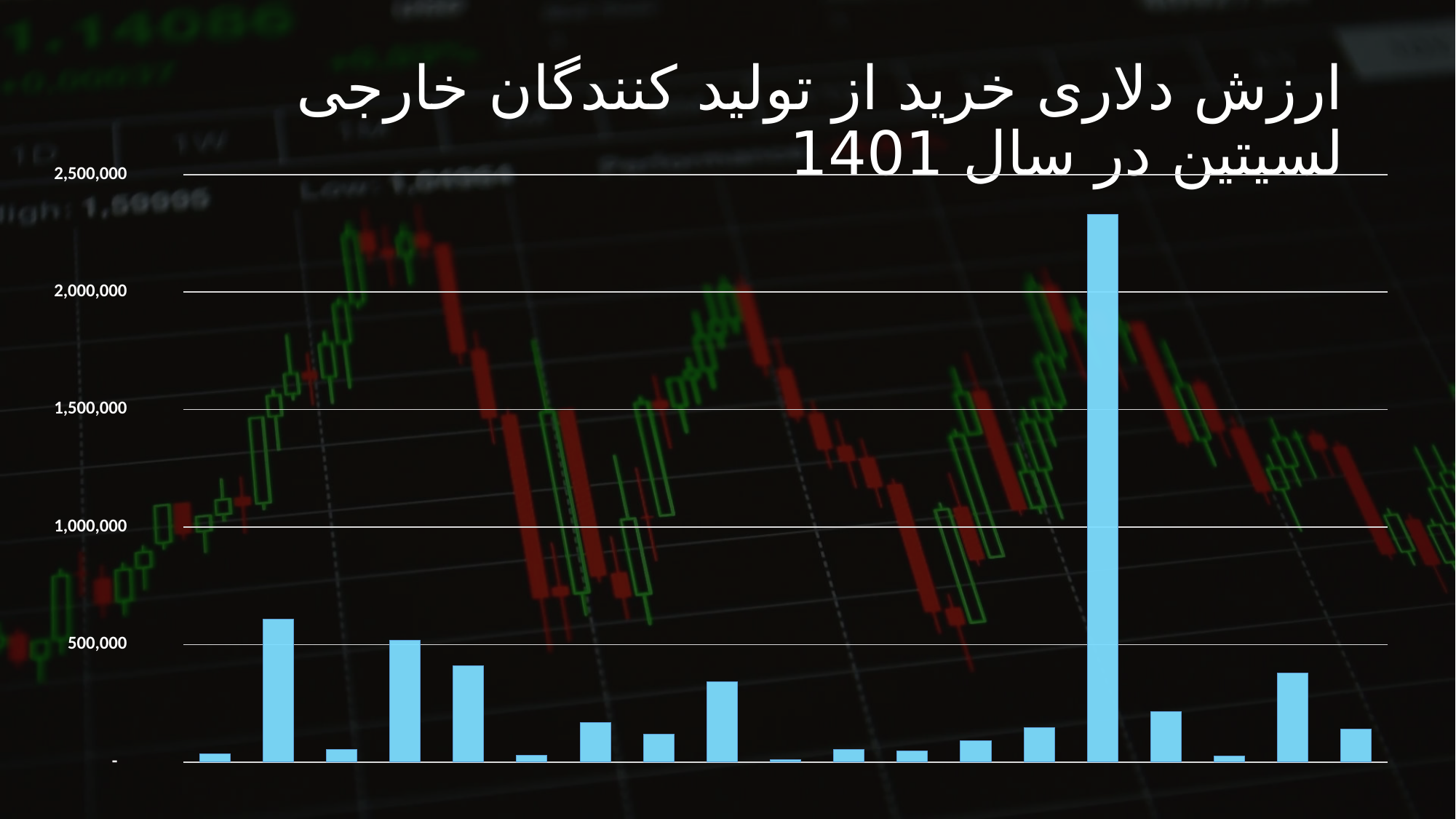
Is the value of the tallest bar greater or less than 2,000,000? greater What is the highest value shown on the vertical axis? 2,500,000 What kind of chart is shown on the slide? bar chart What colour are the bars in the chart? light blue Is the value of the fifth bar from the left greater or less than 500,000? less Is the second bar from the left taller or shorter than the fifth bar from the left? taller Is the value of the second bar from the left greater or less than 500,000? greater How many bars are plotted in the chart? 19 Is the tallest bar taller or shorter than the second bar from the left? taller Which bar is the highest in the chart, counting from the left? the 15th bar